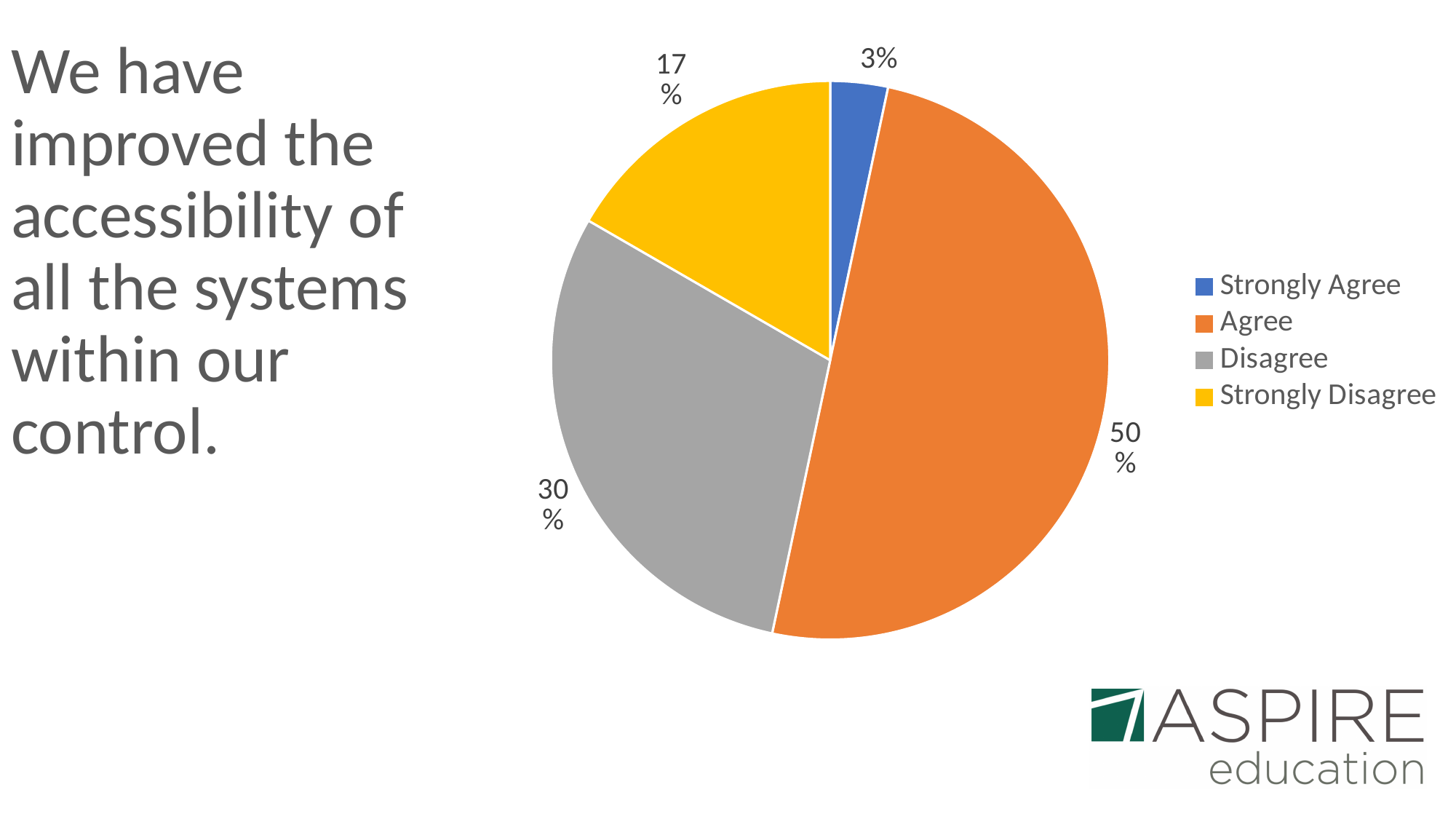
What percentage of respondents chose Strongly Disagree? 17% What colour is the Strongly Disagree slice? yellow What percentage of respondents chose Strongly Agree? 3% What percentage of respondents chose Agree? 50% Which is larger, the share for Disagree or the share for Strongly Disagree? Disagree What percentage of respondents chose Disagree? 30% What statement were respondents asked to rate, according to the slide text? We have improved the accessibility of all the systems within our control. What is the difference in percentage points between Agree and Disagree? 20 How many categories does the legend list? 4 Which response has the smallest share of the pie? Strongly Agree Which response has the largest share of the pie? Agree What kind of chart is shown on the slide? pie chart